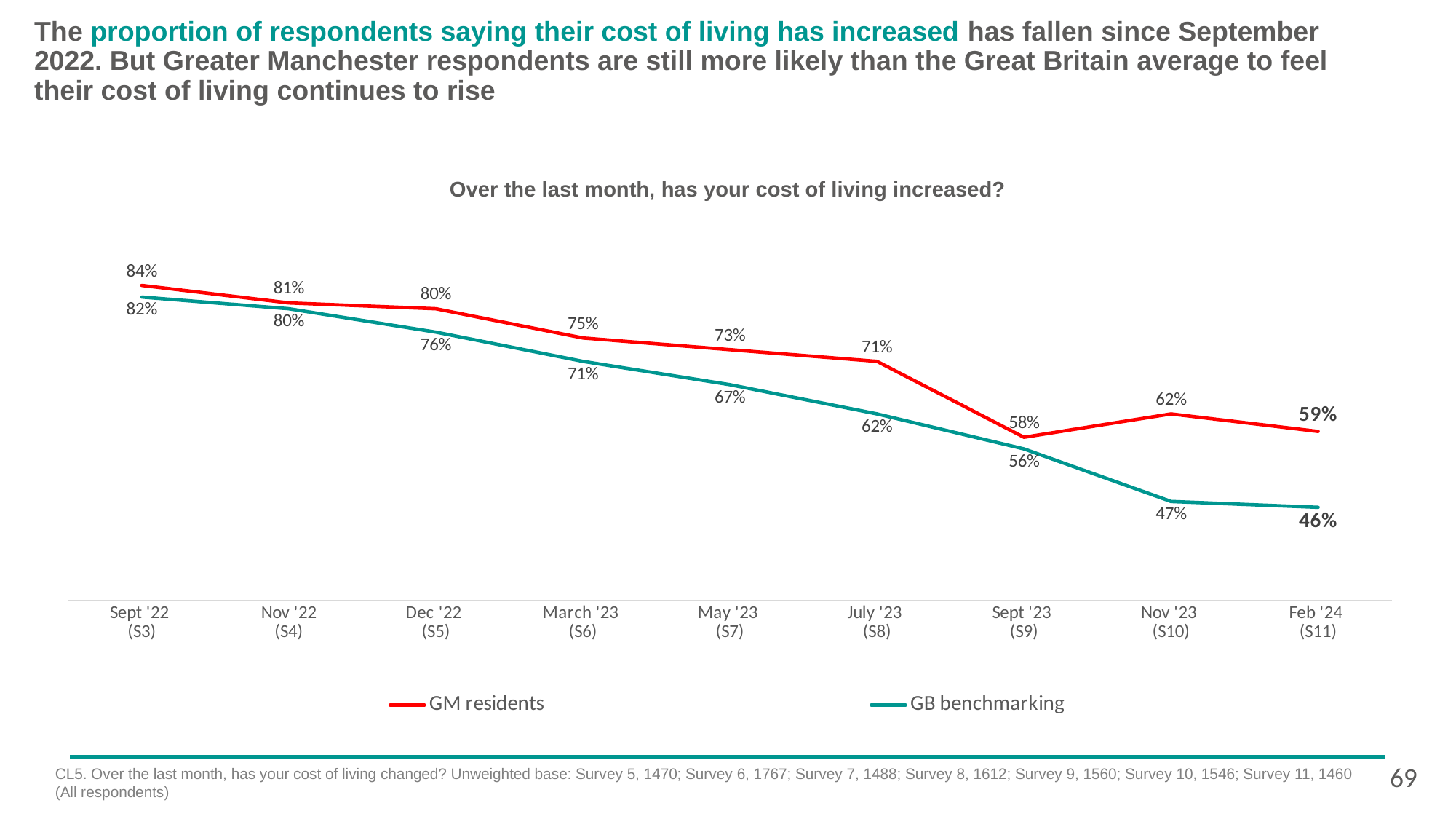
Which series has the higher value in Sept '23 (S9), GM residents or GB benchmarking? GM residents What is the value for GM residents in Nov '23 (S10)? 62% What kind of chart is shown on the slide? Line chart What is the value for GM residents in Sept '22 (S3)? 84% How many survey waves are plotted on the x axis? 9 Does the GB benchmarking series rise or fall from Sept '22 to Feb '24? Fall How many series does the legend list? 2 What is the value for GB benchmarking in Feb '24 (S11)? 46% In which survey wave is the GB benchmarking value highest? Sept '22 (S3) What is the value for GB benchmarking in July '23 (S8)? 62% What is the difference between GM residents and GB benchmarking in Feb '24 (S11)? 13 percentage points In which survey wave is the GM residents value lowest? Sept '23 (S9)